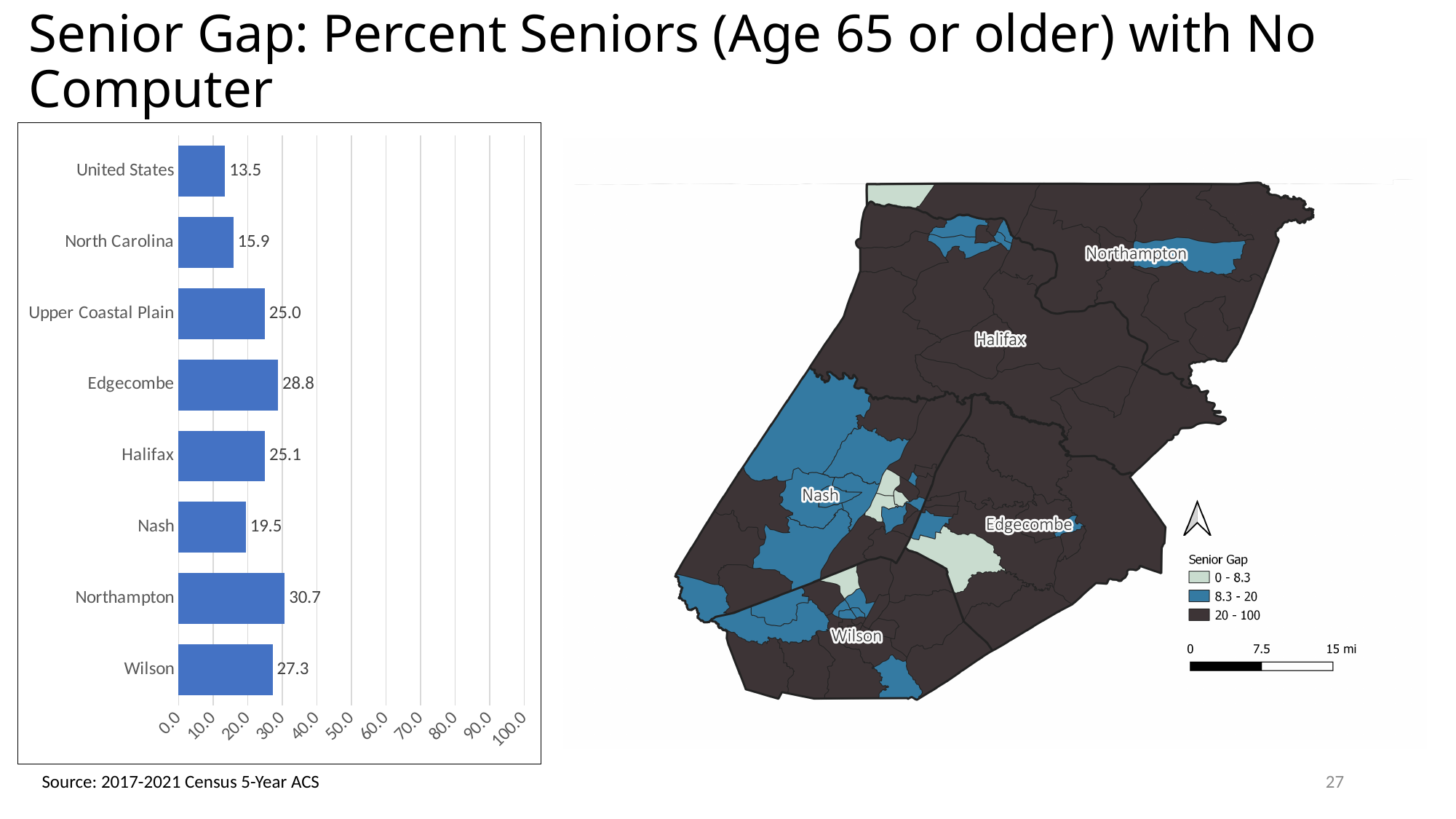
In the bar chart, which is larger, the value for Edgecombe or the value for Halifax? Edgecombe Which category has the lowest value in the bar chart? United States What is the value for Upper Coastal Plain in the bar chart? 25.0 How many categories are shown in the bar chart? 8 What is the maximum value shown on the x axis of the bar chart? 100.0 What kind of chart is shown on the left of the slide? bar chart What is the difference between the values for Edgecombe and Nash in the bar chart? 9.3 What is the difference between the values for Northampton and Wilson in the bar chart? 3.4 What is the value for United States in the bar chart? 13.5 What is the value for Northampton in the bar chart? 30.7 In the bar chart, is the value for Nash greater or less than 20.0? less Which category has the highest value in the bar chart? Northampton